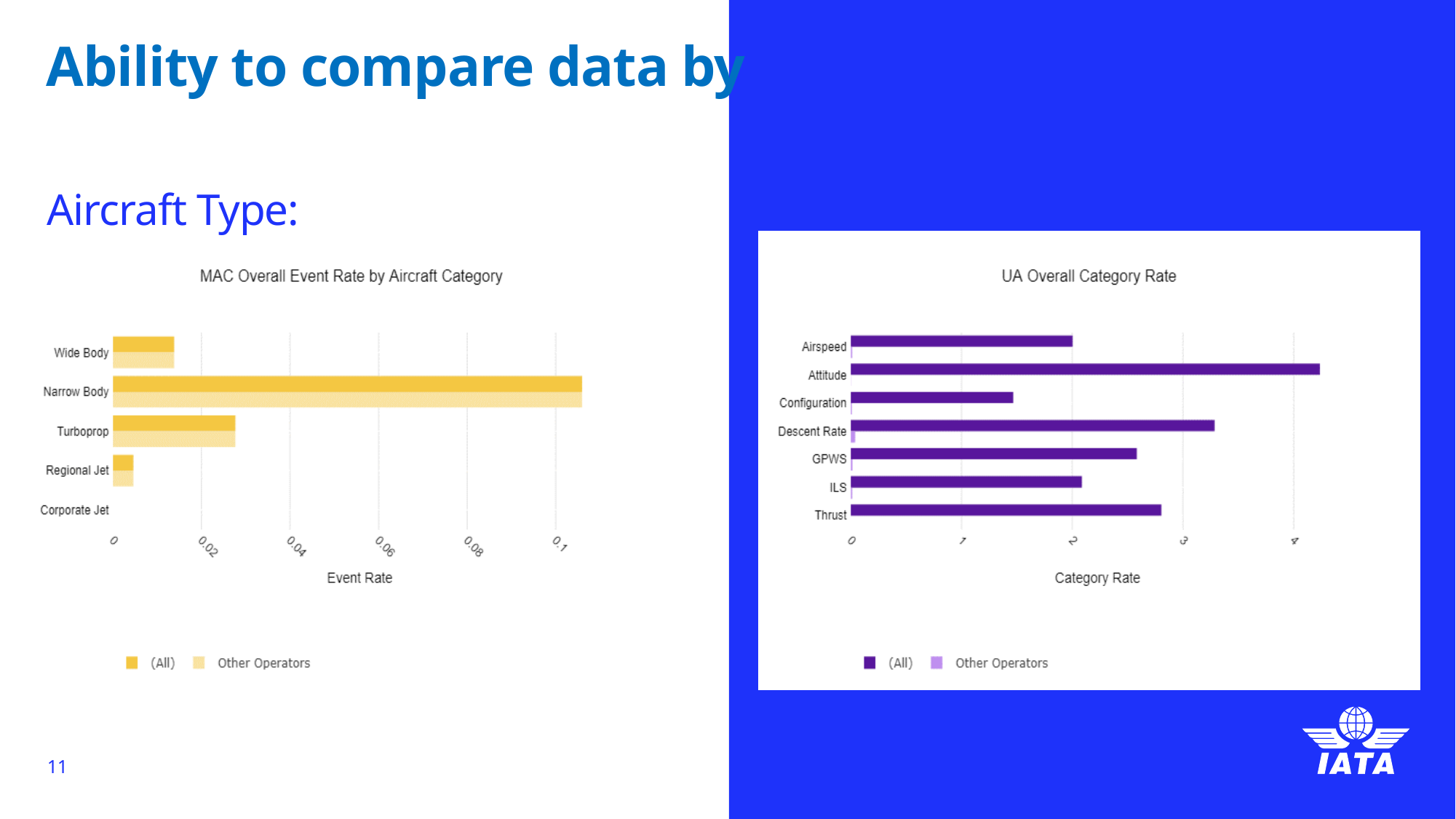
In the 'UA Overall Category Rate' chart, how many categories are listed on the vertical axis? 7 In the 'UA Overall Category Rate' chart, which category has the highest (All) category rate? Attitude In the 'MAC Overall Event Rate by Aircraft Category' chart, which aircraft category has the highest event rate? Narrow Body In the 'UA Overall Category Rate' chart, which category has the lowest (All) category rate? Configuration In the 'MAC Overall Event Rate by Aircraft Category' chart, is the (All) event rate for Wide Body greater or less than 0.02? less In the 'MAC Overall Event Rate by Aircraft Category' chart, is the (All) event rate for Narrow Body greater or less than 0.1? greater What type of chart is the 'MAC Overall Event Rate by Aircraft Category' chart? bar chart In the 'UA Overall Category Rate' chart, is the (All) category rate for Descent Rate greater or less than 3? greater In the 'MAC Overall Event Rate by Aircraft Category' chart, how many aircraft categories are listed on the vertical axis? 5 In the 'MAC Overall Event Rate by Aircraft Category' chart, what is the label of the horizontal axis? Event Rate In the 'MAC Overall Event Rate by Aircraft Category' chart, how many series does the legend list? 2 In the 'UA Overall Category Rate' chart, which has the larger (All) category rate, Descent Rate or Thrust? Descent Rate